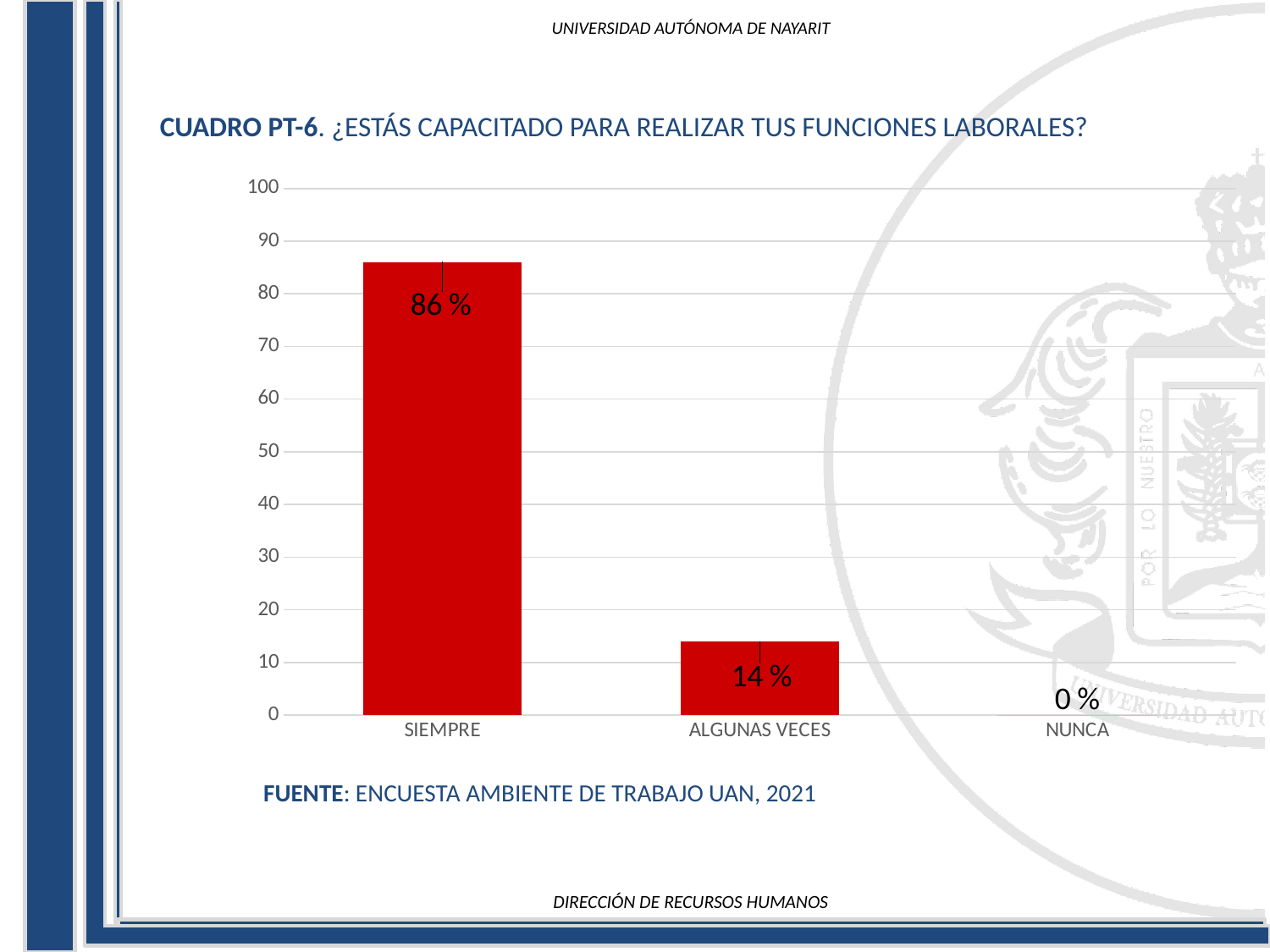
Is the value for SIEMPRE greater or less than 80? greater What is the value for NUNCA? 0 % What is the value for ALGUNAS VECES? 14 % Is the value for ALGUNAS VECES greater or less than 20? less What is the value for SIEMPRE? 86 % Which is larger, the value for ALGUNAS VECES or the value for NUNCA? ALGUNAS VECES Which category has the highest value? SIEMPRE What kind of chart is shown on the slide? bar chart What is the title of the chart? CUADRO PT-6. ¿ESTÁS CAPACITADO PARA REALIZAR TUS FUNCIONES LABORALES? Which category has the lowest value? NUNCA How many categories are shown on the x axis? 3 What is the difference between the values for SIEMPRE and ALGUNAS VECES? 72 %